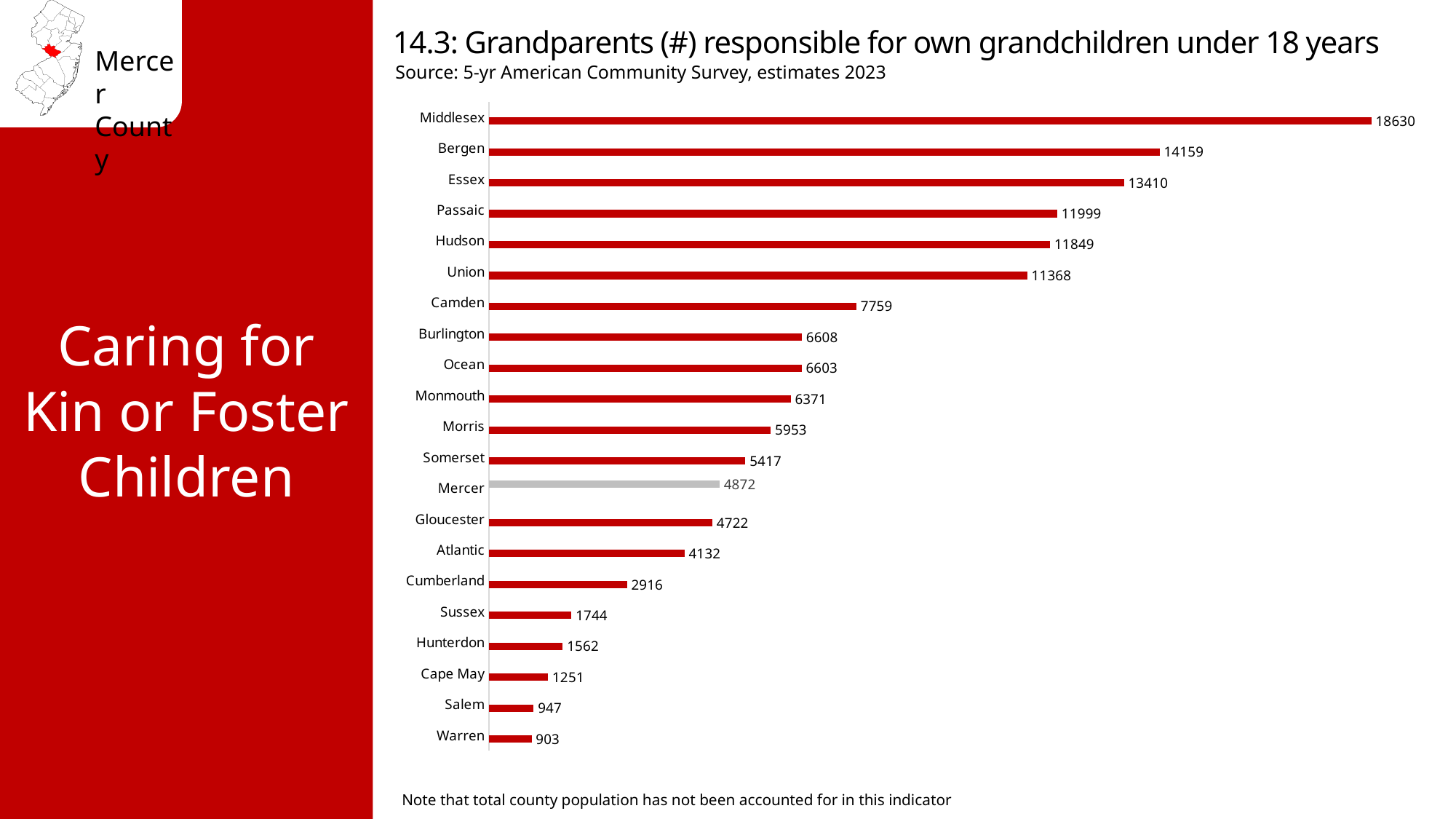
Which county has the highest value? Middlesex What is the difference between the values for Bergen and Essex? 749 Which is larger, the value for Sussex or the value for Cape May? Sussex Which county's bar is shown in grey rather than red? Mercer What kind of chart is shown on the slide? Bar chart What is the value for Middlesex? 18630 Which is larger, the value for Camden or the value for Morris? Camden What is the difference between the values for Mercer and Gloucester? 150 How many counties are shown in the chart? 21 What is the value for Cumberland? 2916 Which county has the lowest value? Warren What is the value for Mercer? 4872